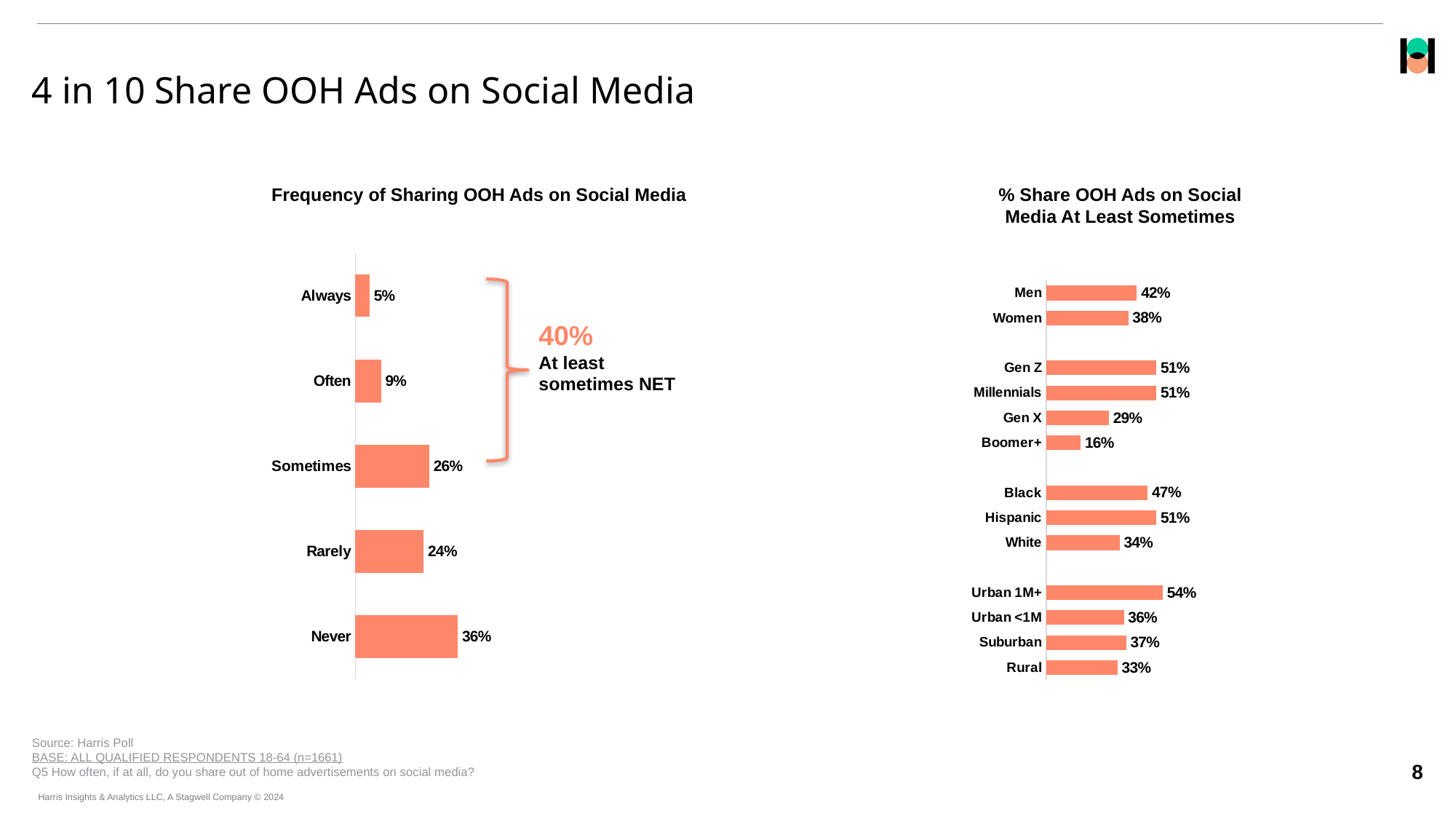
In the '% Share OOH Ads on Social Media At Least Sometimes' chart, what is the value for Gen X? 29% In the 'Frequency of Sharing OOH Ads on Social Media' chart, what is the 'At least sometimes NET' value shown next to the bracket? 40% In the '% Share OOH Ads on Social Media At Least Sometimes' chart, which category has the lowest value? Boomer+ In the 'Frequency of Sharing OOH Ads on Social Media' chart, which category has the highest value? Never In the '% Share OOH Ads on Social Media At Least Sometimes' chart, what is the difference between Black and White? 13% In the 'Frequency of Sharing OOH Ads on Social Media' chart, what is the value for Sometimes? 26% In the 'Frequency of Sharing OOH Ads on Social Media' chart, what is the difference between Never and Rarely? 12% In the 'Frequency of Sharing OOH Ads on Social Media' chart, how many categories are shown? 5 In the '% Share OOH Ads on Social Media At Least Sometimes' chart, which is larger, Men or Women? Men In the 'Frequency of Sharing OOH Ads on Social Media' chart, which category has the lowest value? Always In the '% Share OOH Ads on Social Media At Least Sometimes' chart, which category has the highest value? Urban 1M+ What type of chart is the '% Share OOH Ads on Social Media At Least Sometimes' chart? Bar chart